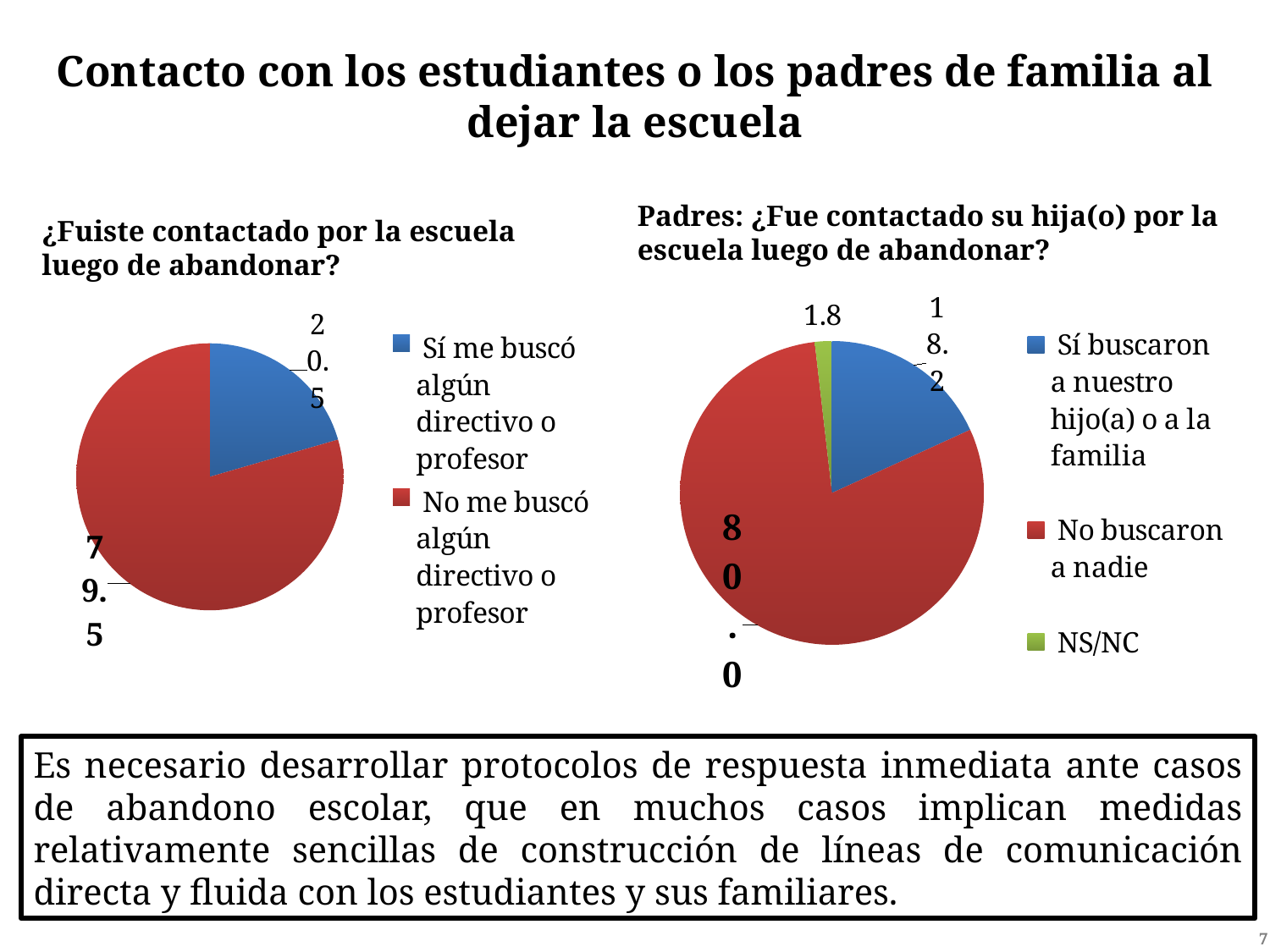
In the right chart (Padres: ¿Fue contactado su hija(o) por la escuela luego de abandonar?), what is the value for 'NS/NC'? 1.8 In the left chart (¿Fuiste contactado por la escuela luego de abandonar?), what is the value for 'No me buscó algún directivo o profesor'? 79.5 In the left chart (¿Fuiste contactado por la escuela luego de abandonar?), what is the difference between the 'No me buscó' and 'Sí me buscó' values? 59.0 In the right chart (Padres: ¿Fue contactado su hija(o) por la escuela luego de abandonar?), what is the value for 'Sí buscaron a nuestro hijo(a) o a la familia'? 18.2 In the right chart (Padres: ¿Fue contactado su hija(o) por la escuela luego de abandonar?), what is the value for 'No buscaron a nadie'? 80.0 In the left chart (¿Fuiste contactado por la escuela luego de abandonar?), which is larger: 'Sí me buscó algún directivo o profesor' or 'No me buscó algún directivo o profesor'? No me buscó algún directivo o profesor In the right chart (Padres: ¿Fue contactado su hija(o) por la escuela luego de abandonar?), which category has the largest slice? No buscaron a nadie In the right chart (Padres: ¿Fue contactado su hija(o) por la escuela luego de abandonar?), what is the difference between 'No buscaron a nadie' and 'Sí buscaron a nuestro hijo(a) o a la familia'? 61.8 In the right chart (Padres: ¿Fue contactado su hija(o) por la escuela luego de abandonar?), which category has the smallest slice? NS/NC What type of chart is the left chart (¿Fuiste contactado por la escuela luego de abandonar?)? Pie chart In the left chart (¿Fuiste contactado por la escuela luego de abandonar?), what is the value for 'Sí me buscó algún directivo o profesor'? 20.5 How many categories does the right chart (Padres: ¿Fue contactado su hija(o) por la escuela luego de abandonar?) show? 3